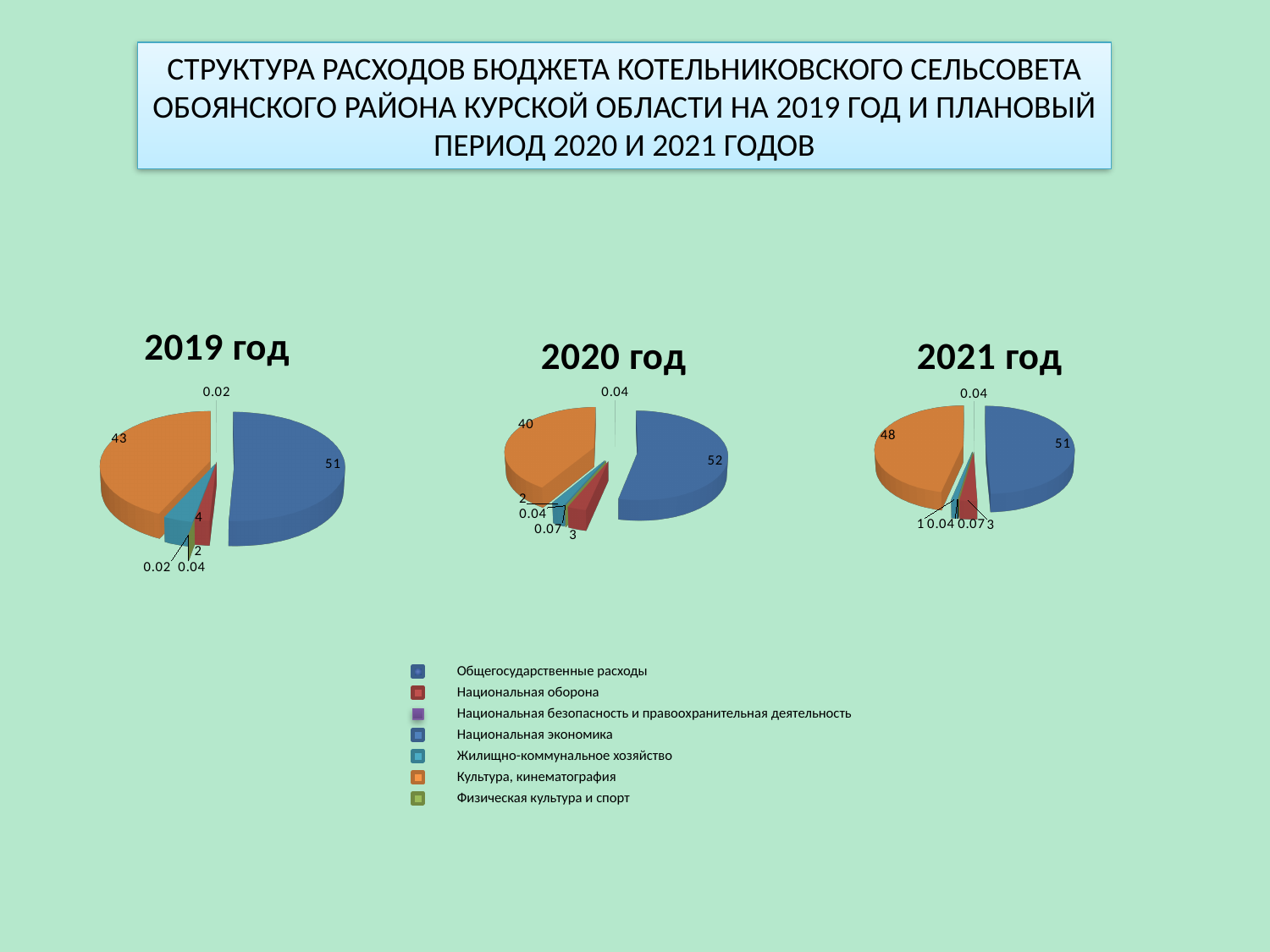
In the 2019 год chart, what is the value for Культура, кинематография (orange slice)? 43 In the 2019 год chart, what is the value for Общегосударственные расходы (blue slice)? 51 In the 2021 год chart, which is larger: the Общегосударственные расходы slice or the Культура, кинематография slice? Общегосударственные расходы In the 2019 год chart, what is the difference between the Общегосударственные расходы slice and the Культура, кинематография slice? 8 What kind of charts are shown on the slide? Pie charts In the 2020 год chart, which category has the largest slice? Общегосударственные расходы In the 2020 год chart, what is the value for Общегосударственные расходы (blue slice)? 52 How many categories does the legend list? 7 In the 2021 год chart, what is the value for Культура, кинематография (orange slice)? 48 How many pie charts are on the slide? 3 In the 2021 год chart, what is the value for Национальная оборона (red slice)? 3 What is the title of the leftmost pie chart? 2019 год